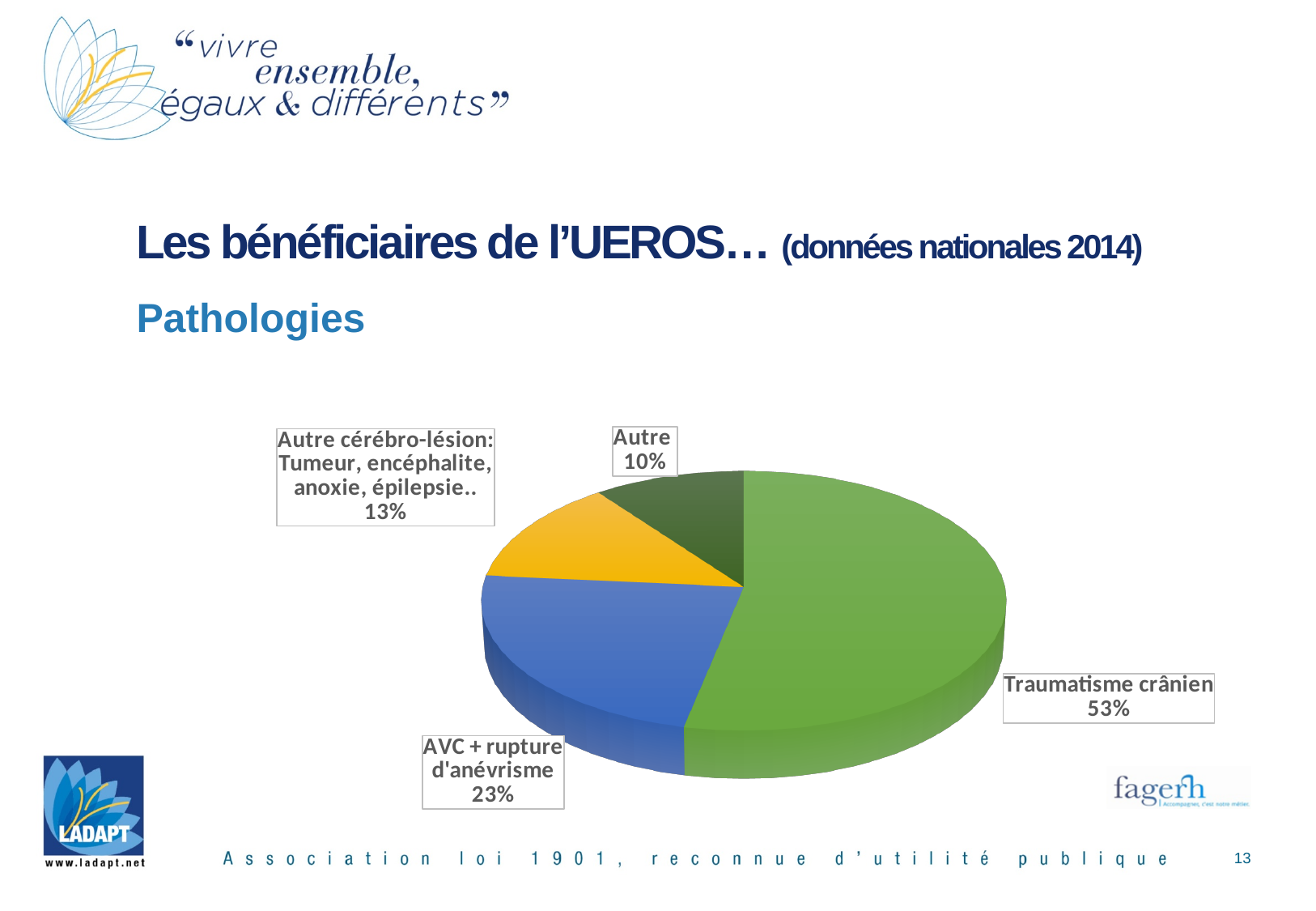
How many slices does the pie chart have? 4 Which pathology has the largest share of the pie? Traumatisme crânien What is the value shown for AVC + rupture d'anévrisme? 23% What is the value shown for Autre cérébro-lésion: Tumeur, encéphalite, anoxie, épilepsie..? 13% What kind of chart is shown on the slide? pie chart What is the difference in percentage points between Traumatisme crânien and AVC + rupture d'anévrisme? 30 What share of the pie does Traumatisme crânien represent? 53% What colour is the Traumatisme crânien slice? green Which is larger: AVC + rupture d'anévrisme or Autre cérébro-lésion? AVC + rupture d'anévrisme What is the difference in percentage points between Autre cérébro-lésion and Autre? 3 What is the value shown for the Autre slice? 10% Which pathology has the smallest share of the pie? Autre